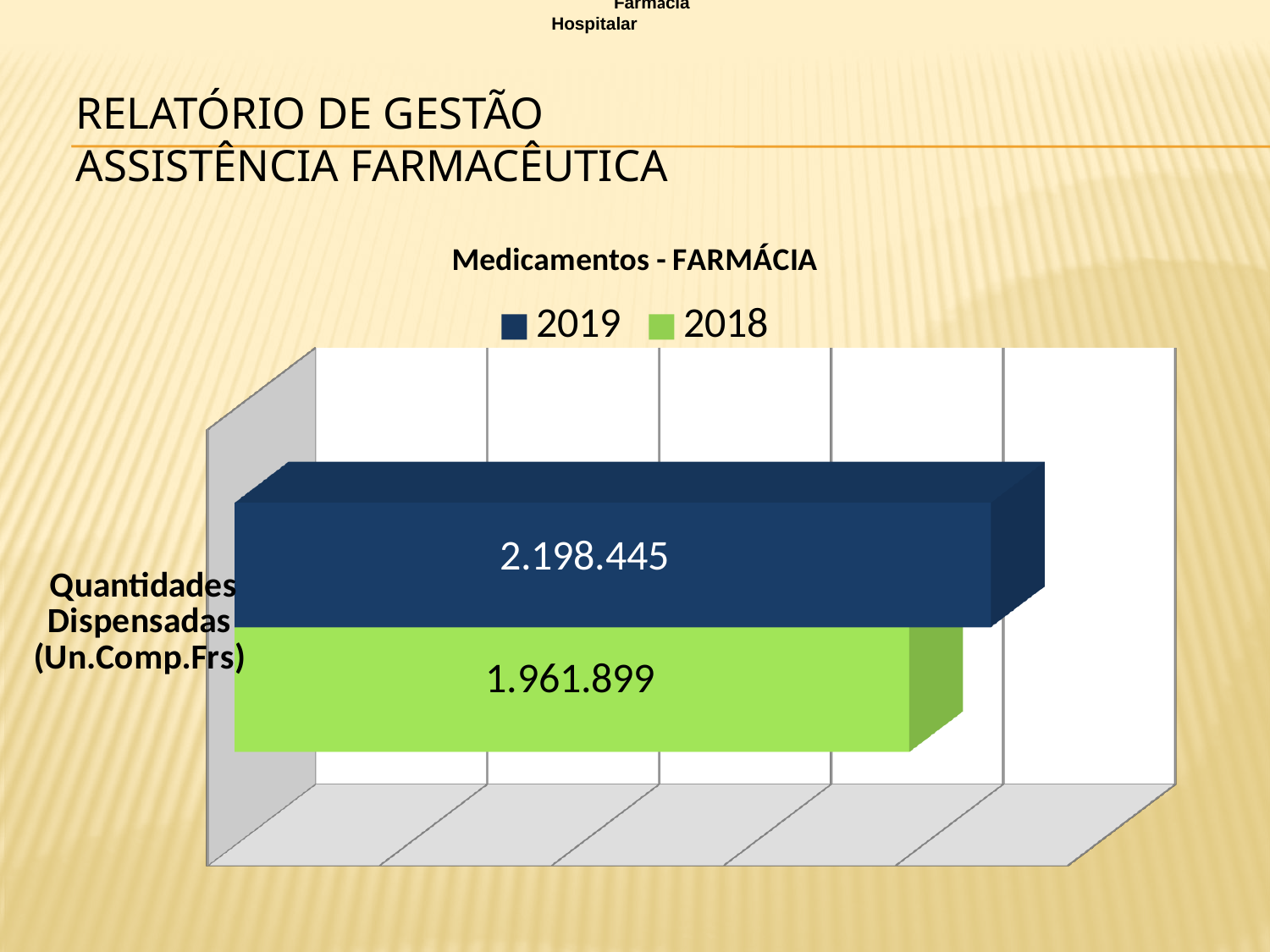
What is the label of the category shown on the chart's axis? Quantidades Dispensadas (Un.Comp.Frs) What is the title of the chart? Medicamentos - FARMÁCIA Which series has the higher value, 2019 or 2018? 2019 How many series does the legend list? 2 Which series shows the highest value in the chart? 2019 What is the value for 2019 in the Medicamentos - FARMÁCIA chart? 2.198.445 What is the difference between the 2019 value and the 2018 value? 236.546 Which series shows the lowest value in the chart? 2018 What is the value for 2018 in the Medicamentos - FARMÁCIA chart? 1.961.899 What kind of chart is shown on the slide? Bar chart How many categories are shown on the category axis of the chart? 1